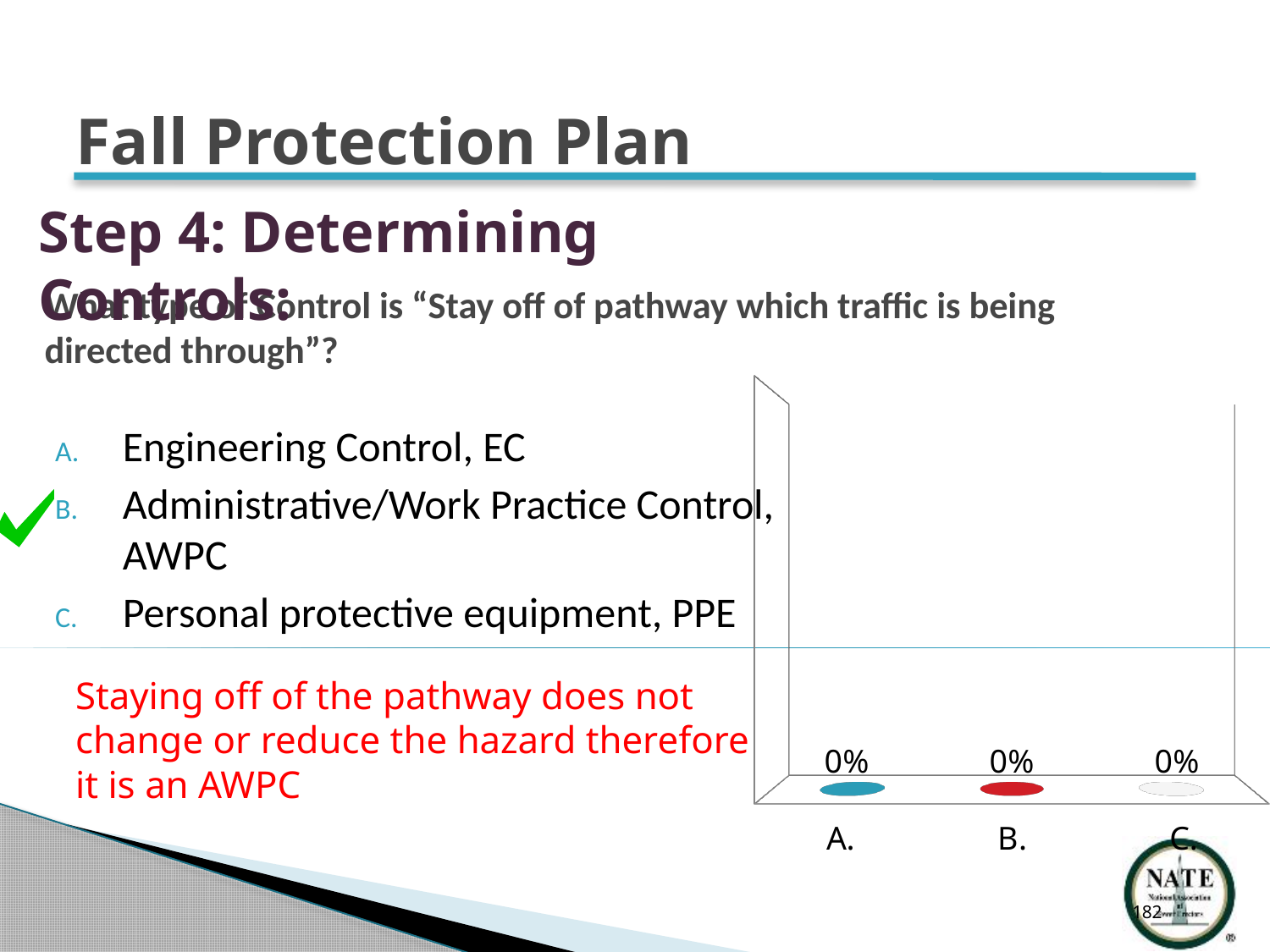
What colour is the marker for category B. in the chart? red How many categories are shown on the x axis of the chart? 3 What kind of chart is shown on the slide? bar chart What are the category labels along the x axis of the chart? A., B., C. Do the values rise, fall, or stay the same from A. to C. along the x axis? stay the same What is the value shown for category C. in the chart? 0% What is the value shown for category B. in the chart? 0% What is the difference between the values for A. and B. in the chart? 0% What is the value shown for category A. in the chart? 0%